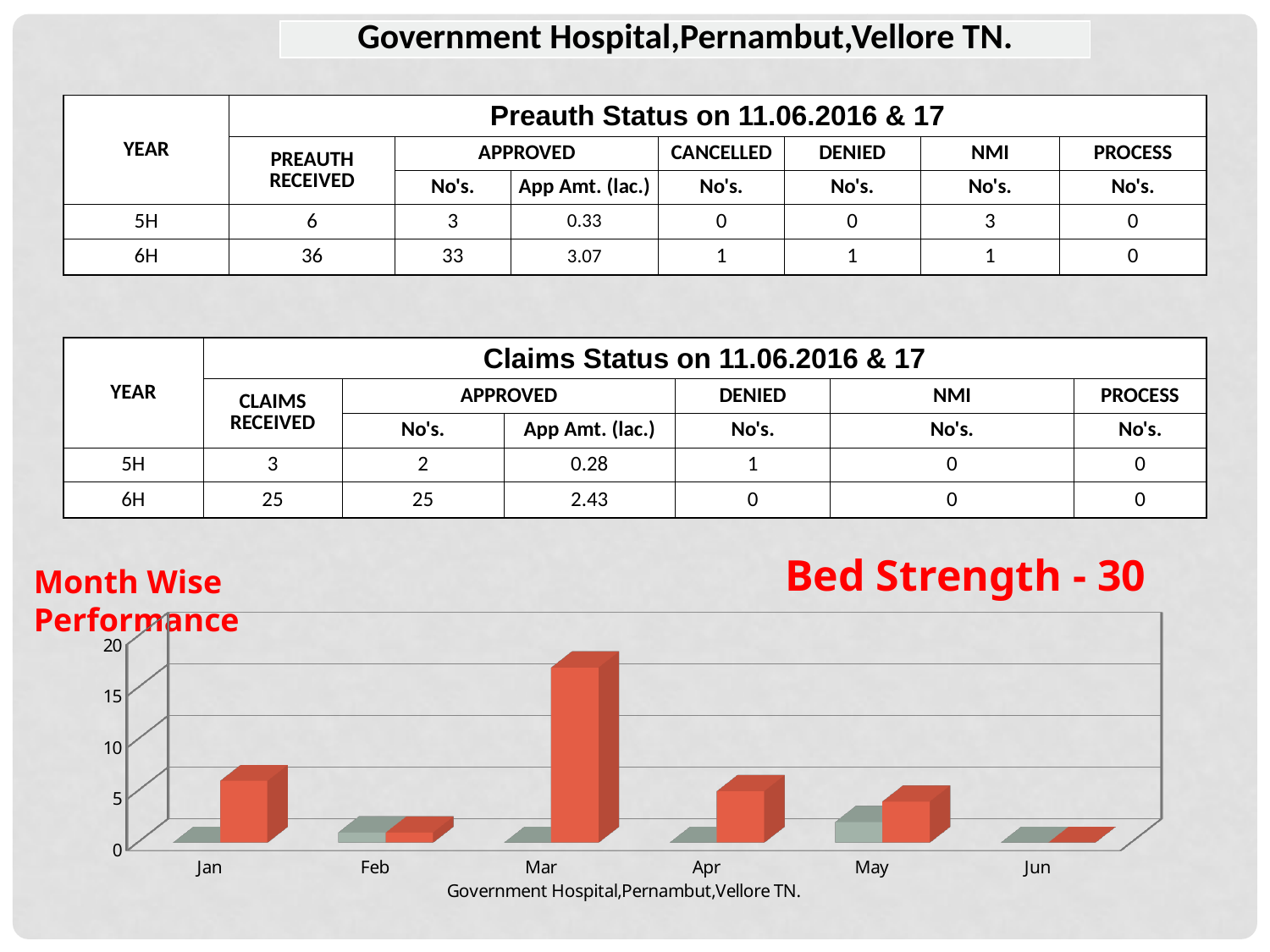
In the Month Wise Performance chart, is the red bar for Apr greater or less than 10? less How many months are shown on the x axis of the Month Wise Performance chart? 6 What is the highest value shown on the vertical axis of the Month Wise Performance chart? 20 What text appears below the month labels on the x axis of the Month Wise Performance chart? Government Hospital,Pernambut,Vellore TN. In the Month Wise Performance chart, which red bar is taller, Mar or Jan? Mar What kind of chart is shown at the bottom of the slide? bar chart In the Month Wise Performance chart, which month has the tallest red bar? Mar In the Month Wise Performance chart, is the red bar for Feb greater or less than 5? less In the Month Wise Performance chart, is the red bar for Jan greater or less than 10? less In the Month Wise Performance chart, which red bar is taller, Jan or Feb? Jan